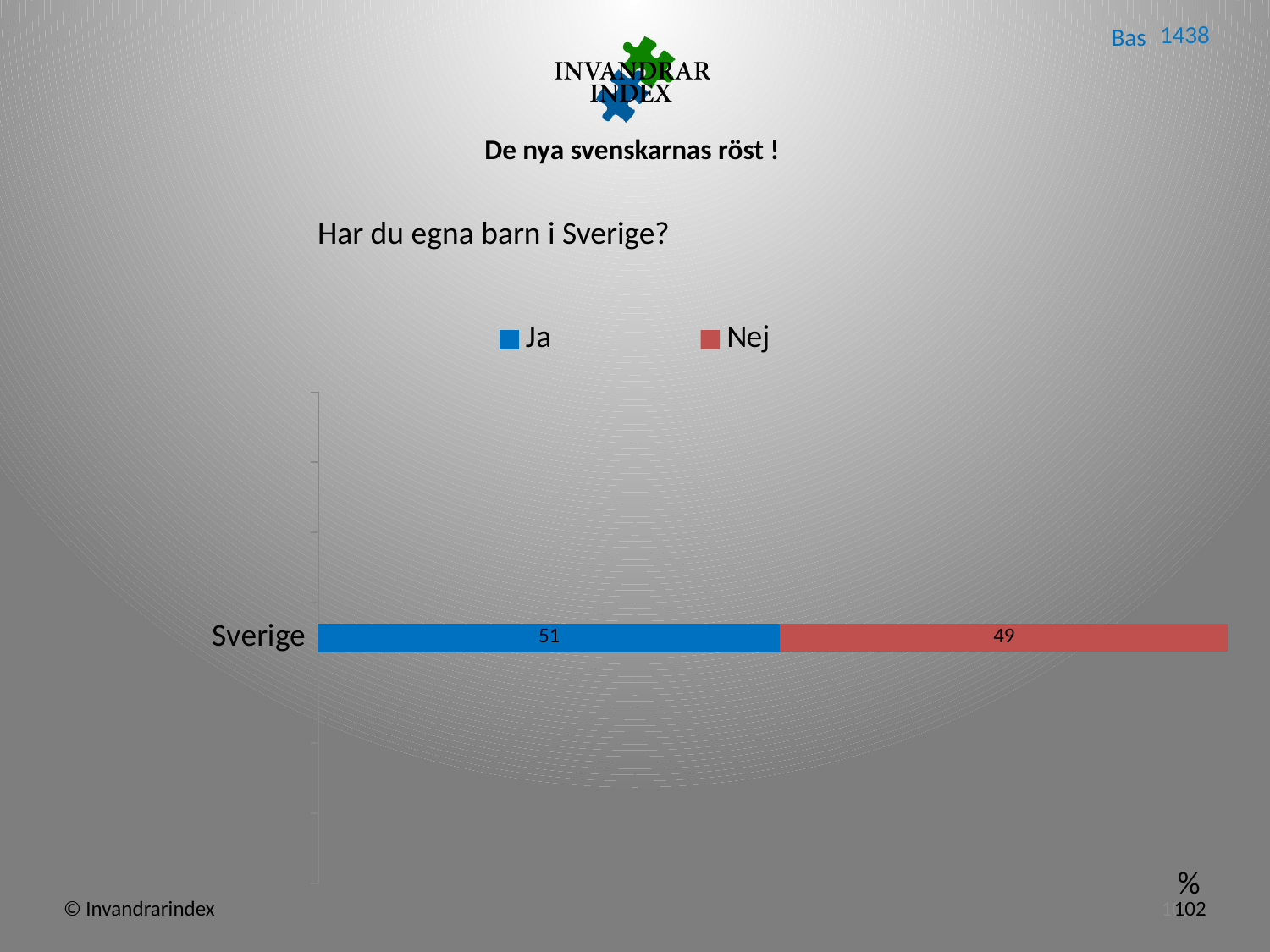
Which series has the larger value for Sverige, Ja or Nej? Ja How many series does the legend list? 2 How many categories are shown on the chart? 1 What is the difference between the Ja and Nej values for Sverige? 2 Which colour represents Nej in the chart? Red What kind of chart is shown on the slide? Stacked bar chart What is the value for Ja for Sverige? 51 What is the name of the category shown on the chart? Sverige What is the total of the stacked bar for Sverige? 100 What is the value for Nej for Sverige? 49 What question is the chart about? Har du egna barn i Sverige?